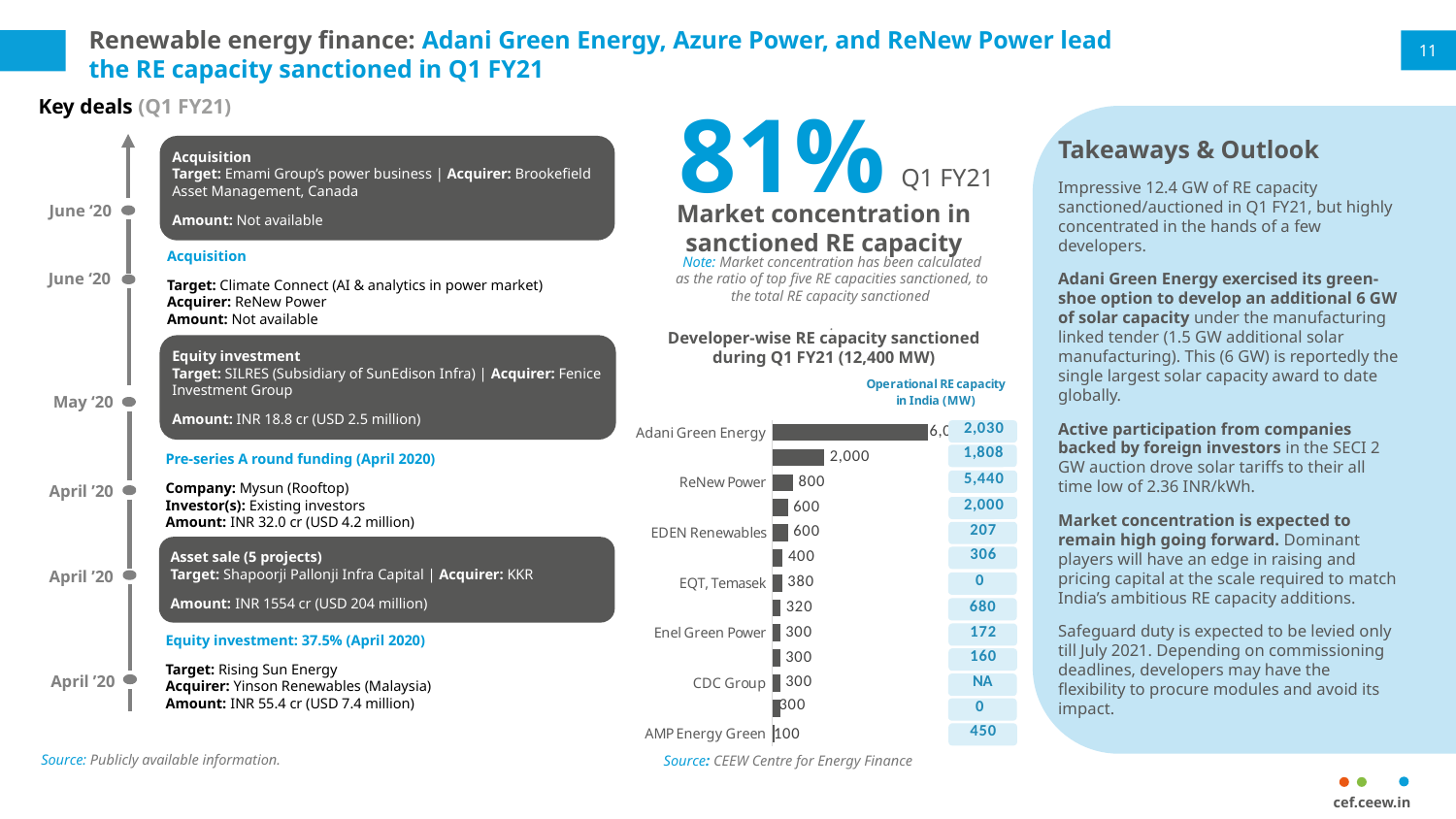
In the developer-wise RE capacity sanctioned chart, what is the value for ReNew Power? 800 What kind of chart is used to show developer-wise RE capacity sanctioned during Q1 FY21? Bar chart How many bars are plotted in the developer-wise RE capacity sanctioned chart? 13 According to the chart title, what is the total RE capacity sanctioned during Q1 FY21? 12,400 MW In the developer-wise RE capacity sanctioned chart, what is the value for Enel Green Power? 300 In the developer-wise RE capacity sanctioned chart, which is larger: the value for ReNew Power or the value for EQT, Temasek? ReNew Power In the developer-wise RE capacity sanctioned chart, what is the difference between the values for ReNew Power and EDEN Renewables? 200 In the developer-wise RE capacity sanctioned chart, what is the value for EDEN Renewables? 600 Which developer has the largest sanctioned RE capacity in the developer-wise chart? Adani Green Energy In the developer-wise RE capacity sanctioned chart, what is the value for AMP Energy Green? 100 Which developer has the smallest sanctioned RE capacity in the developer-wise chart? AMP Energy Green In the developer-wise RE capacity sanctioned chart, what is the value for EQT, Temasek? 380